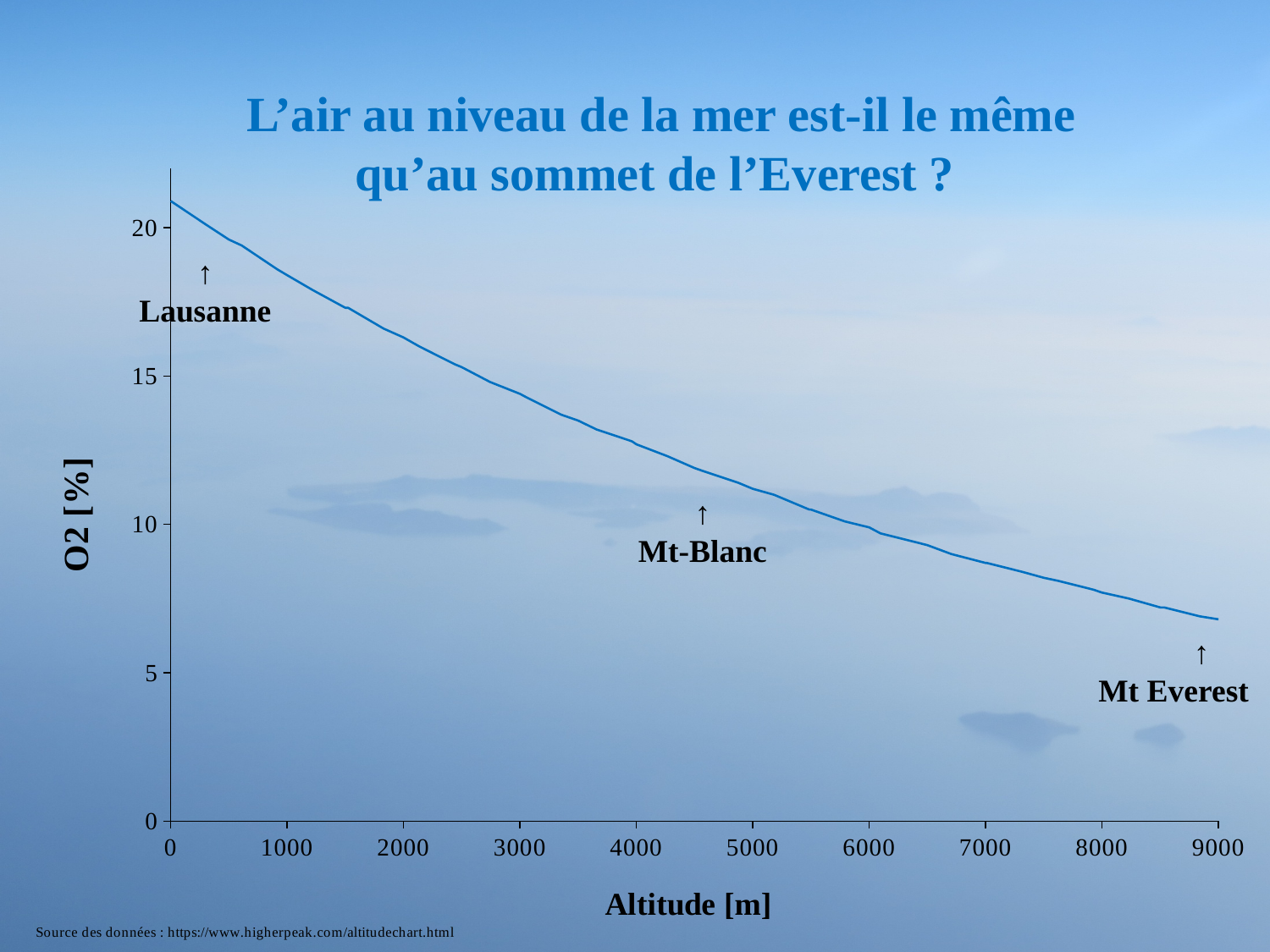
Is the O2 value at an altitude of 0 m greater or less than 20? greater What is the label of the y axis? O2 [%] Which three locations are annotated on the chart? Lausanne, Mt-Blanc, Mt Everest Which has the larger O2 value: an altitude of 1000 m or an altitude of 5000 m? 1000 m Is the O2 value at an altitude of 4000 m greater or less than 10? greater Is the O2 value at an altitude of 9000 m greater or less than 10? less At which altitude on the x axis is the O2 value lowest? 9000 What kind of chart is shown on the slide? line chart Do the O2 values rise or fall as altitude increases along the x axis? fall At which altitude on the x axis is the O2 value highest? 0